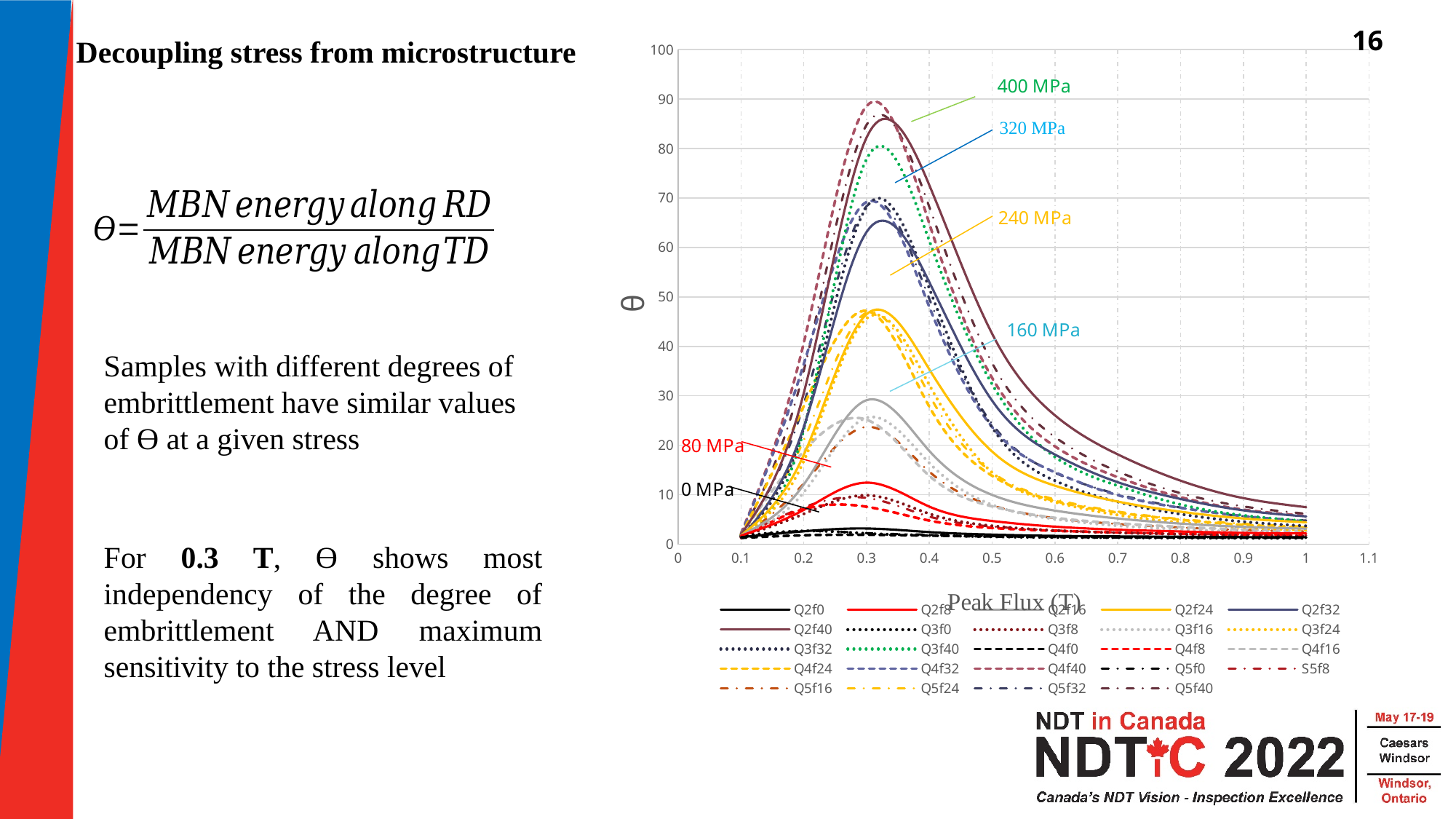
What is the label of the chart's y axis? θ Is the peak value of the Q2f32 curve greater or less than 60? greater Which stress level annotation is attached to the lowest group of curves? 0 MPa Is the peak value of the Q2f40 curve greater or less than 80? greater Do the curves rise or fall as peak flux increases from 0.4 T to 1 T? fall How many series does the chart's legend list? 24 Which curve reaches a higher peak, Q2f40 or Q2f8? Q2f40 Which stress level annotation is attached to the highest group of curves? 400 MPa What is the label of the chart's x axis? Peak Flux (T) Is the peak value of the Q2f24 curve greater or less than 50? less What kind of chart is shown on the slide? Line chart